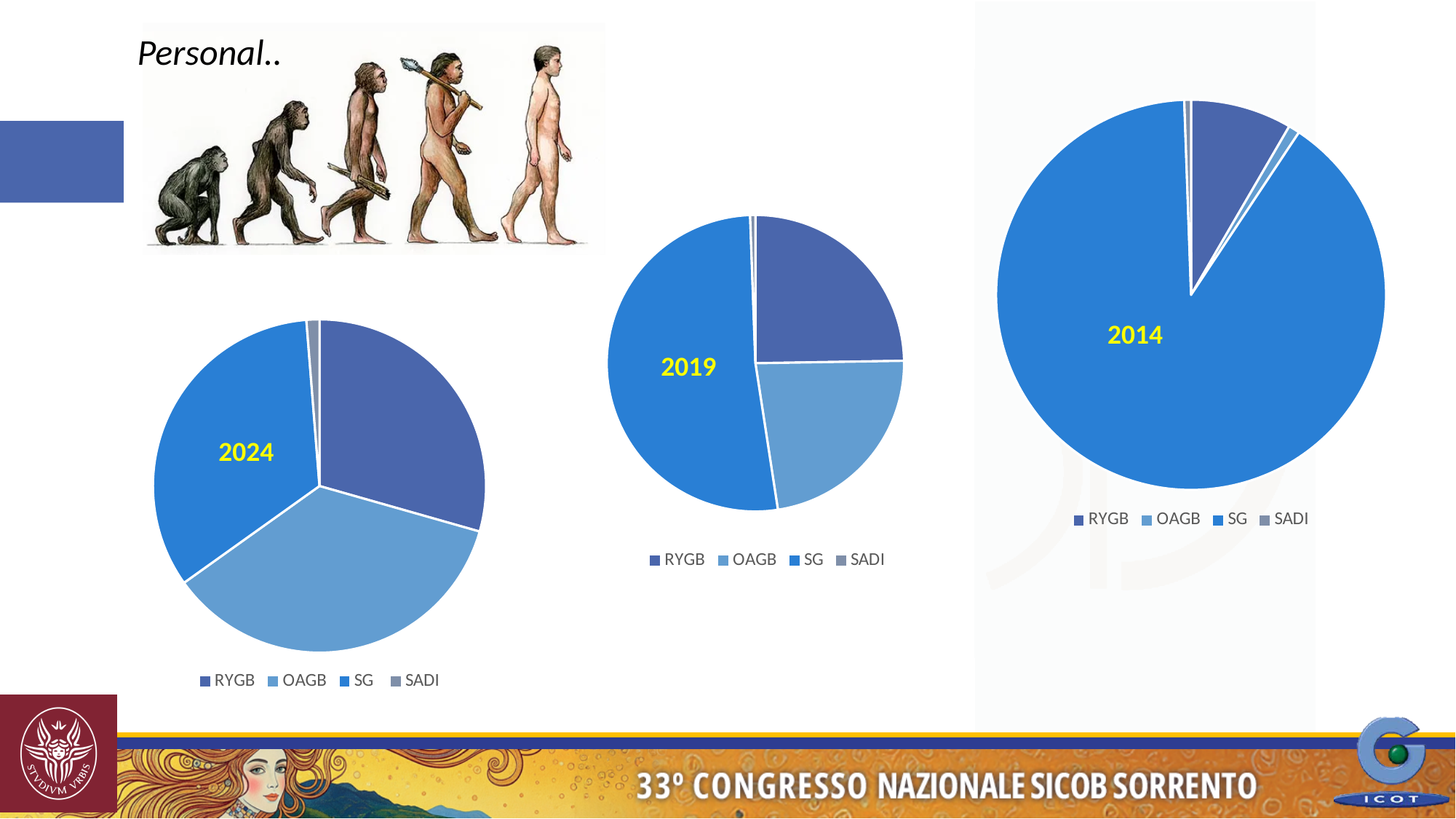
In the 2014 pie chart, which category has the smallest slice? SADI How many charts are shown on the slide? 3 What kind of chart is the chart labelled 2024? pie chart Which year's pie chart has the largest SG slice? 2014 In the 2024 pie chart, which category has the smallest slice? SADI What are the four categories listed in the legend of the 2024 chart? RYGB, OAGB, SG, SADI How many entries does the legend of the 2019 chart list? 4 In the 2019 pie chart, which category has the smallest slice? SADI In the 2014 pie chart, which slice is larger, RYGB or OAGB? RYGB In the 2014 pie chart, which category has the largest slice? SG In the 2024 pie chart, which slice is larger, RYGB or SADI? RYGB In the 2019 pie chart, which category has the largest slice? SG